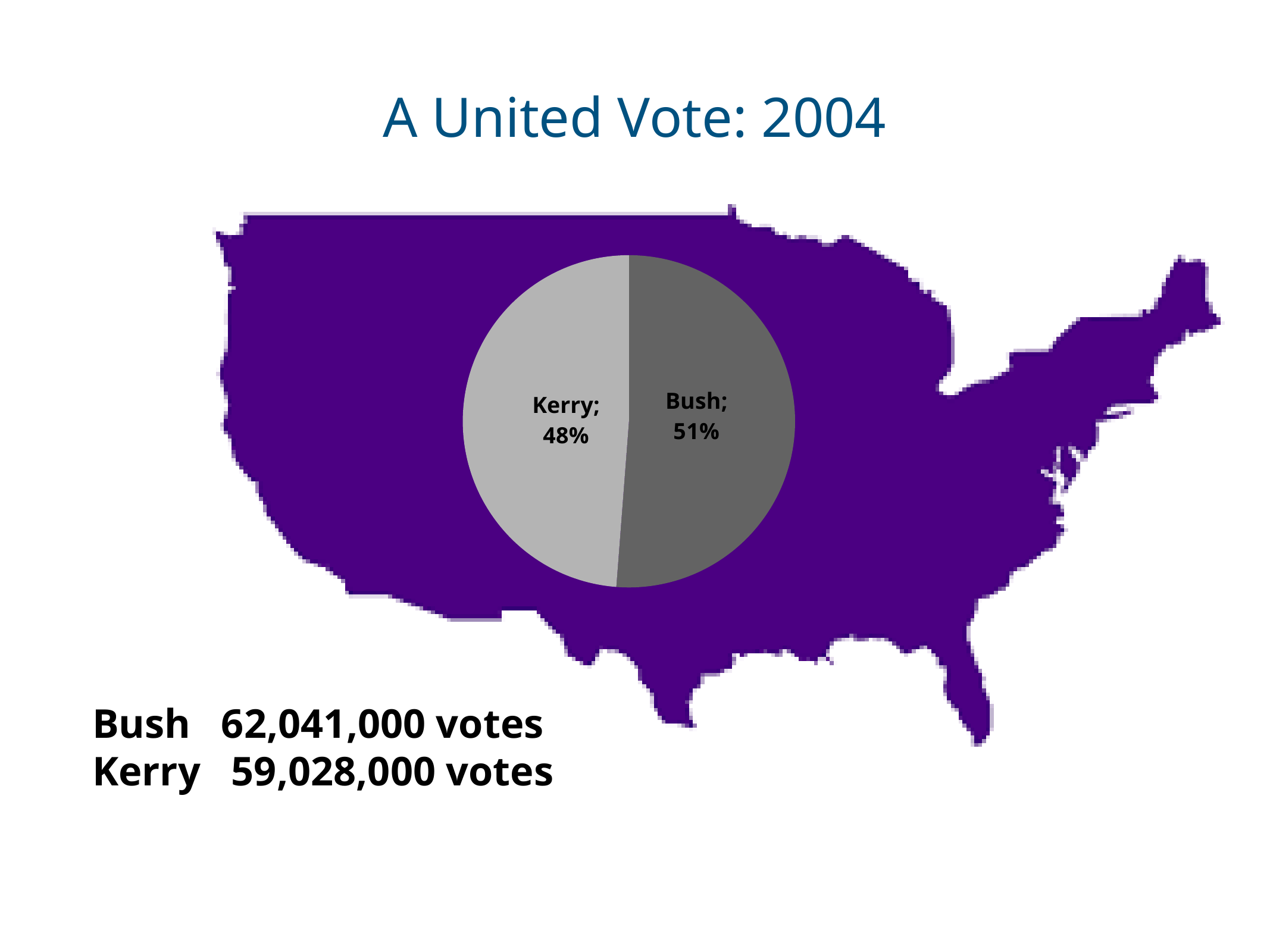
What share of the pie does Bush have? 51% What share of the pie does Kerry have? 48% What is the difference in percentage points between the Bush slice and the Kerry slice? 3% Which slice of the pie is the smallest? Kerry Which is larger, the Bush slice or the Kerry slice? Bush How many slices does the pie chart have? 2 What is the title of the slide containing the pie chart? A United Vote: 2004 Which slice of the pie is shown in the darker grey? Bush Which slice of the pie is the largest? Bush What kind of chart is shown on the slide? pie chart